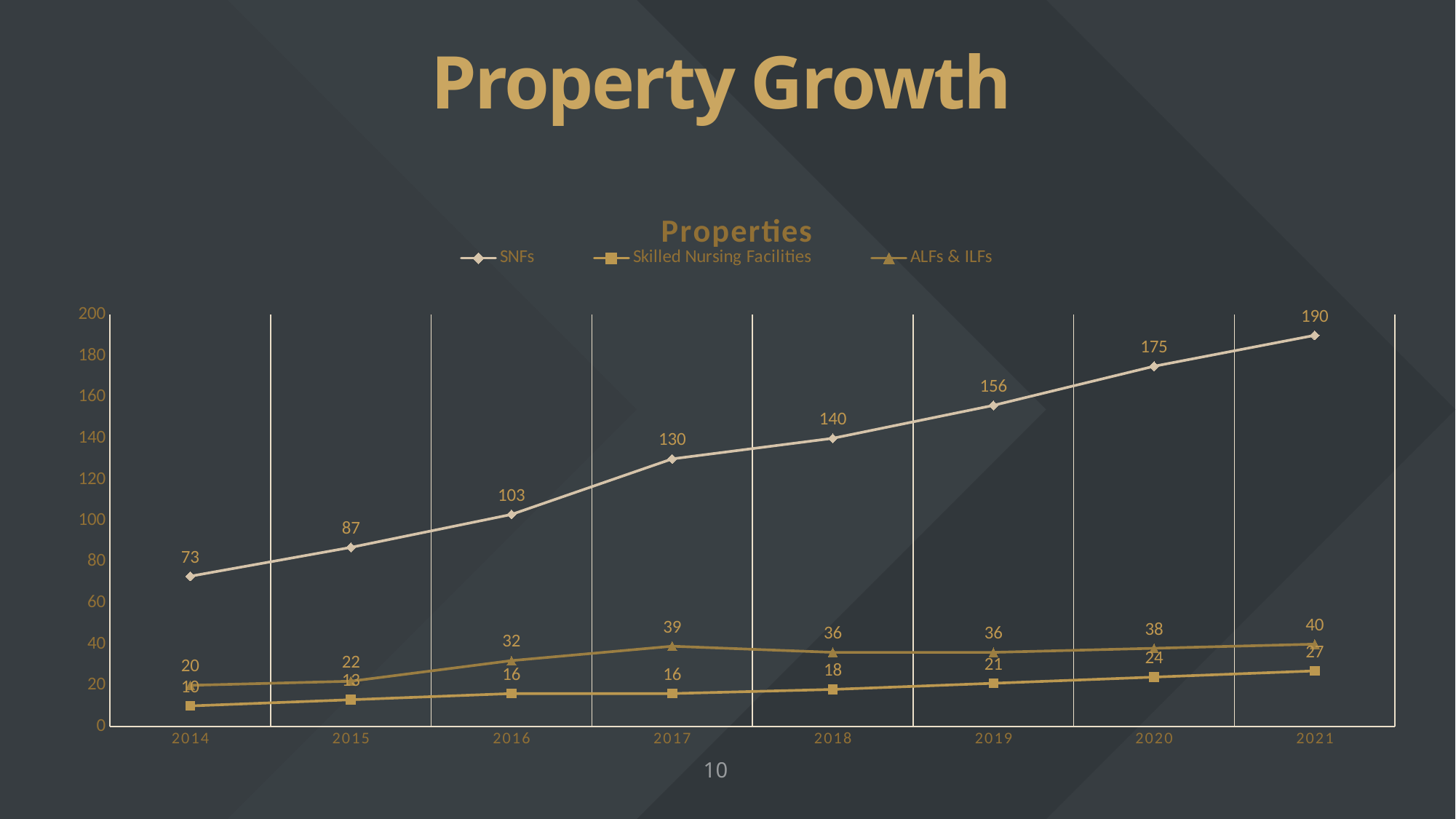
What is the value for Skilled Nursing Facilities in 2020? 24 Which is larger in 2018, the value for ALFs & ILFs or the value for Skilled Nursing Facilities? ALFs & ILFs What is the title of the chart? Properties What type of chart is shown on the slide? line chart In which year is the ALFs & ILFs value highest? 2021 What is the value for ALFs & ILFs in 2017? 39 How many series does the legend list? 3 What is the difference between the SNFs values in 2021 and 2014? 117 How many years are shown on the x axis? 8 Do the SNFs values rise or fall from 2014 to 2021? rise In which year is the SNFs value lowest? 2014 What is the value for SNFs in 2021? 190